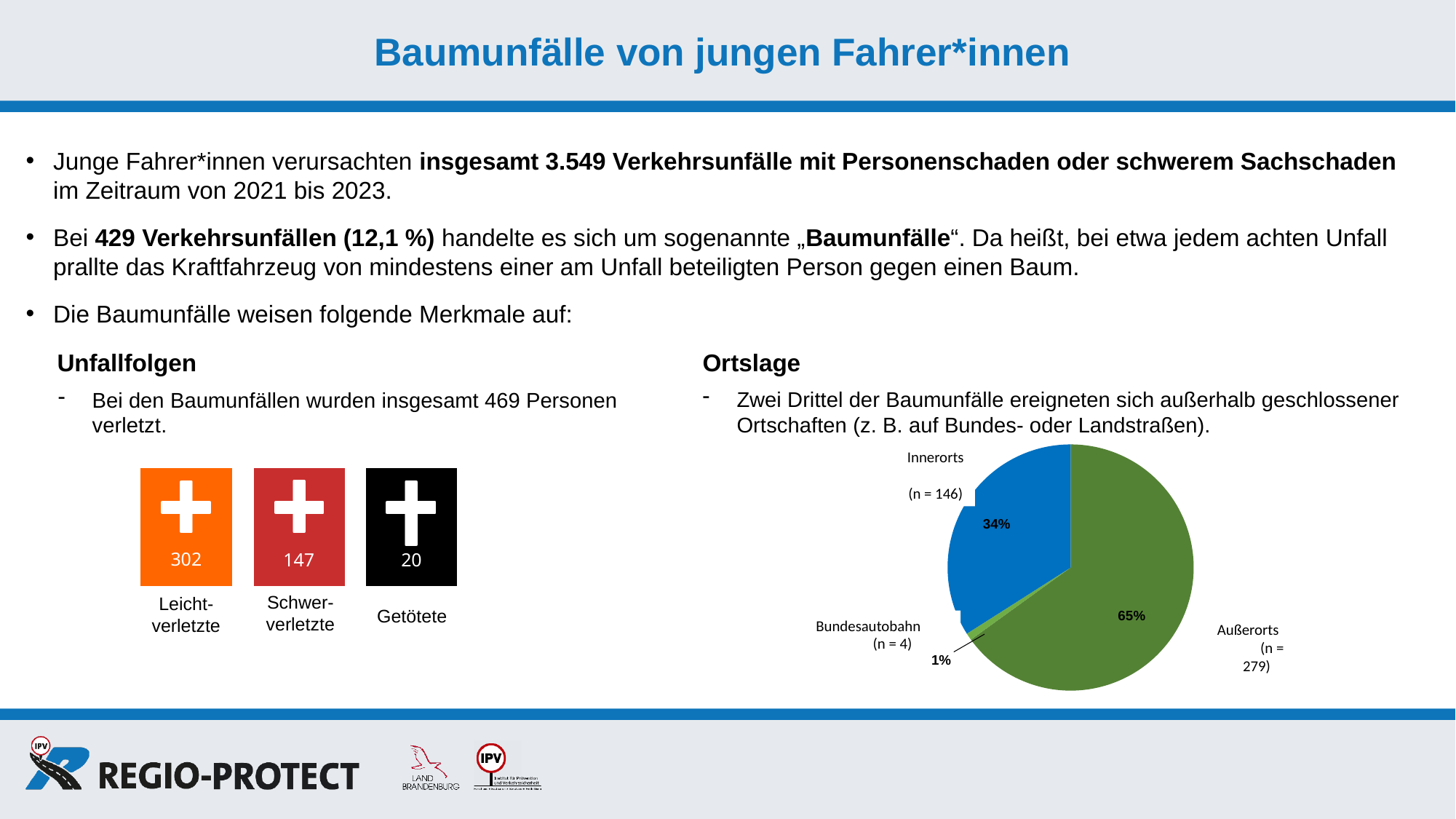
In the pie chart, what is the n value given for Innerorts? 146 In the pie chart, what percentage of tree accidents occurred Innerorts? 34% In the pie chart, what percentage of tree accidents occurred Außerorts? 65% In the pie chart, which is larger: the Innerorts slice or the Außerorts slice? Außerorts Which category has the smallest slice in the pie chart? Bundesautobahn In the pie chart, what is the n value given for Außerorts? 279 Which category has the largest slice in the pie chart? Außerorts What kind of chart is shown under the Ortslage heading? Pie chart In the pie chart, what percentage of tree accidents occurred on the Bundesautobahn? 1% In the pie chart, how many more accidents (n) occurred Außerorts than Innerorts? 133 In the pie chart, what is the n value given for Bundesautobahn? 4 How many slices does the pie chart have? 3